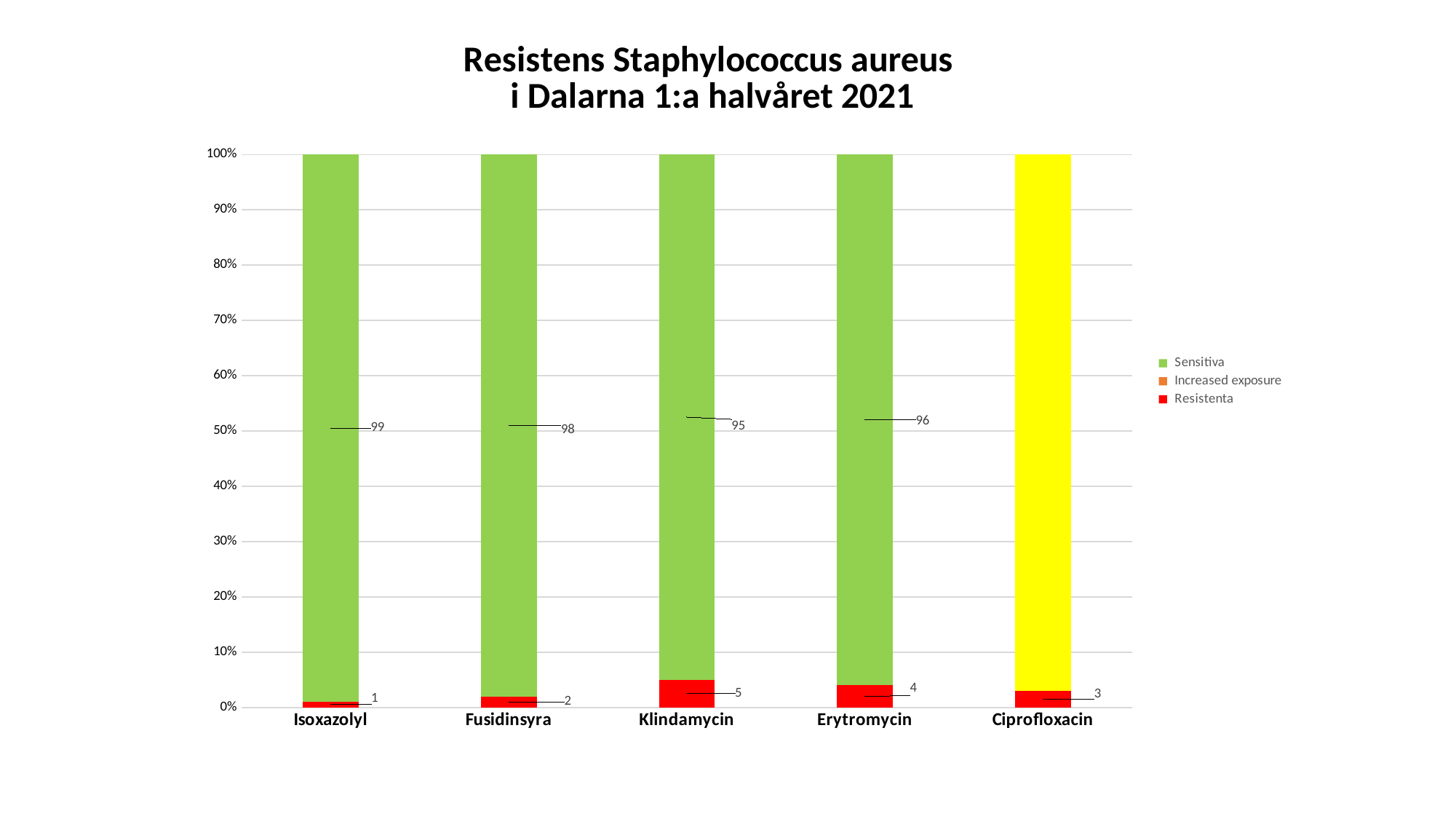
Which antibiotic has the highest Resistenta value? Klindamycin What is the Resistenta value for Ciprofloxacin? 3 How many antibiotics are shown on the x axis? 5 What kind of chart is shown on the slide? Stacked bar chart What is the title of the chart? Resistens Staphylococcus aureus i Dalarna 1:a halvåret 2021 What is the Sensitiva value for Erytromycin? 96 Which has a larger Sensitiva value, Fusidinsyra or Klindamycin? Fusidinsyra What is the difference between the Resistenta values for Klindamycin and Fusidinsyra? 3 What is the Sensitiva value for Isoxazolyl? 99 Which antibiotic has the lowest Resistenta value? Isoxazolyl What is the Resistenta value for Klindamycin? 5 How many series does the legend list? 3